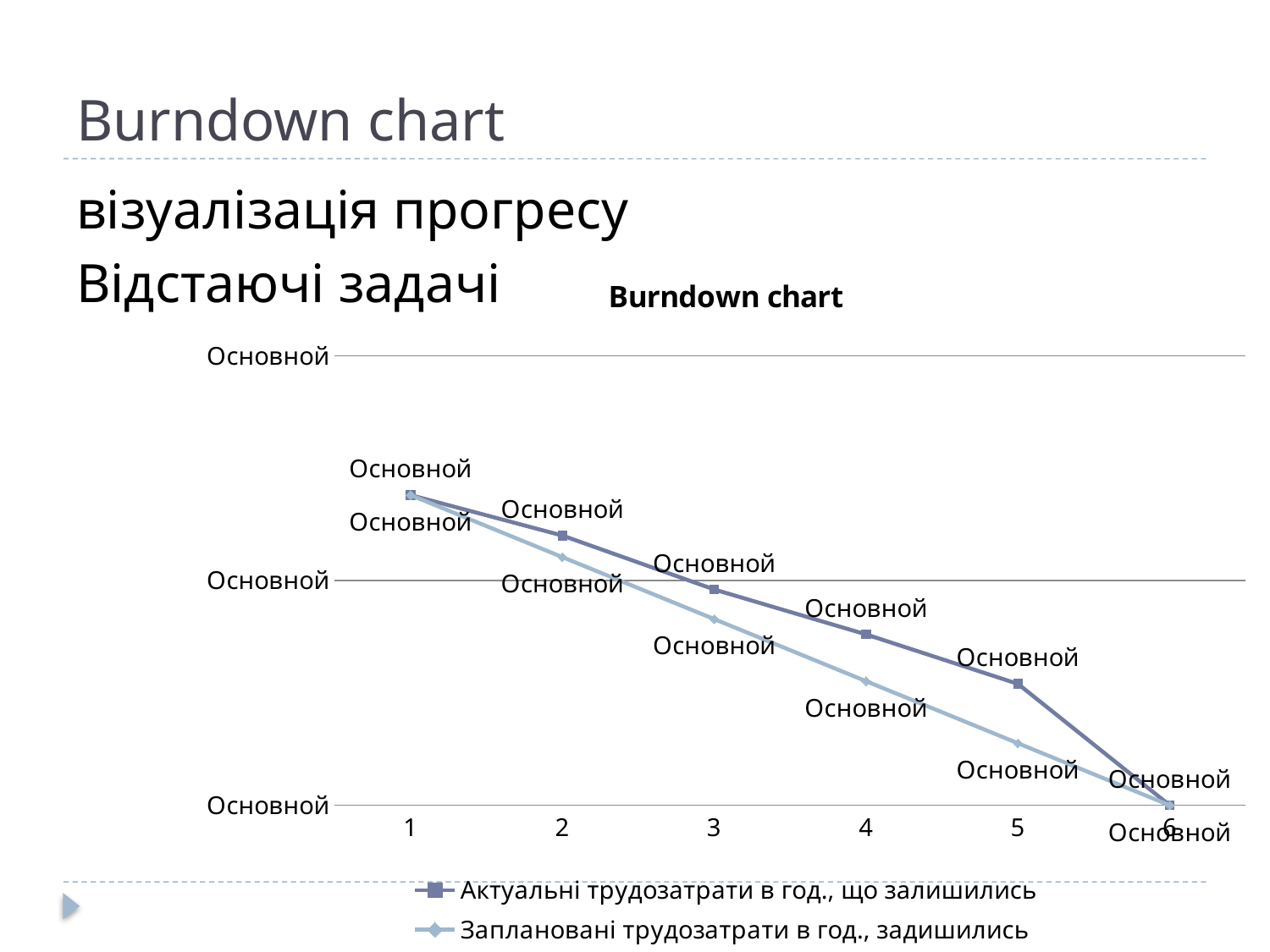
At which x value is the 'Заплановані трудозатрати в год., задишились' series lowest? 6 Which legend entry is shown with square markers? Актуальні трудозатрати в год., що залишились At x = 3, which series has the larger value: 'Актуальні трудозатрати в год., що залишились' or 'Заплановані трудозатрати в год., задишились'? Актуальні трудозатрати в год., що залишились What is the title of the chart? Burndown chart What kind of chart is shown on the slide? line chart At which x value is the 'Актуальні трудозатрати в год., що залишились' series highest? 1 Do the values of the 'Заплановані трудозатрати в год., задишились' series rise or fall along the x axis? fall How many series does the chart's legend list? 2 At x = 5, which series has the smaller value: 'Актуальні трудозатрати в год., що залишились' or 'Заплановані трудозатрати в год., задишились'? Заплановані трудозатрати в год., задишились How many points are plotted along the x axis for each series? 6 Do the values of the 'Актуальні трудозатрати в год., що залишились' series rise or fall from x = 1 to x = 6? fall